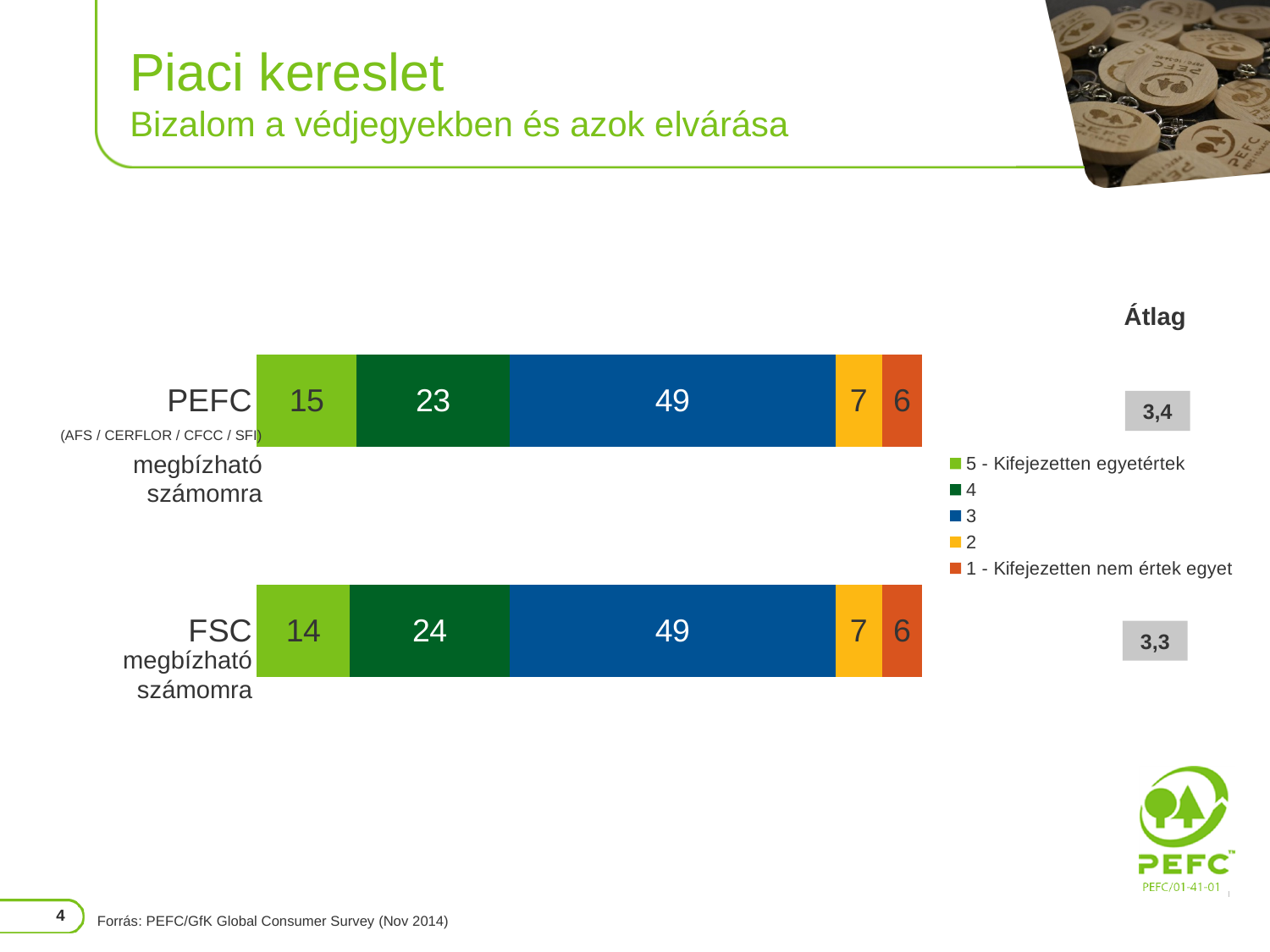
What kind of chart is shown on the slide? stacked bar chart What is the value of the '5 - Kifejezetten egyetértek' segment for PEFC? 15 Which is larger: the '5 - Kifejezetten egyetértek' value for PEFC or for FSC? PEFC What is the total of the PEFC stacked bar? 100 What is the value of the '1 - Kifejezetten nem értek egyet' segment for FSC? 6 How many categories (bars) are plotted in the chart? 2 What is the difference between the '4' segment values for FSC and PEFC? 1 How many series does the legend list? 5 What is the value of the '4' segment for FSC? 24 Which segment is the largest in the PEFC bar? 3 What is the value of the '3' segment for PEFC? 49 Which segment is the smallest in the FSC bar? 1 - Kifejezetten nem értek egyet